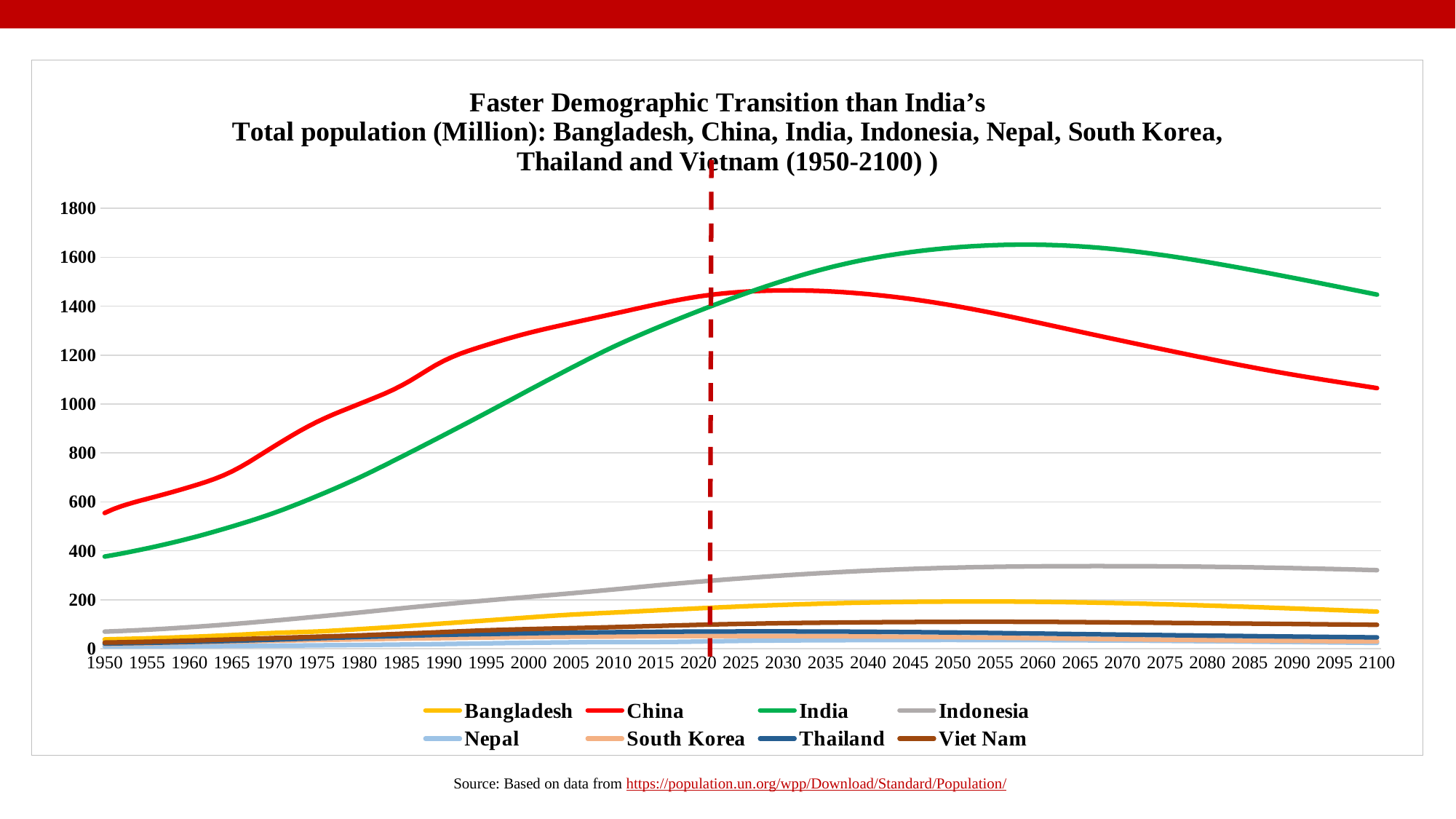
What kind of chart is shown on the slide? line chart Is the value for China in 2100 greater or less than 1000? greater Does China's population rise or fall between 2030 and 2100? fall Is the value for Bangladesh in 2100 greater or less than 200? less Which country has the highest population in 1950? China How many series does the legend list? 8 Which is larger in 2100, the population of India or of China? India What colour is the line for India in the legend? green How many year labels are shown along the x axis? 31 Which country has the highest population in 2100? India Is the value for China in 1950 greater or less than 400? greater